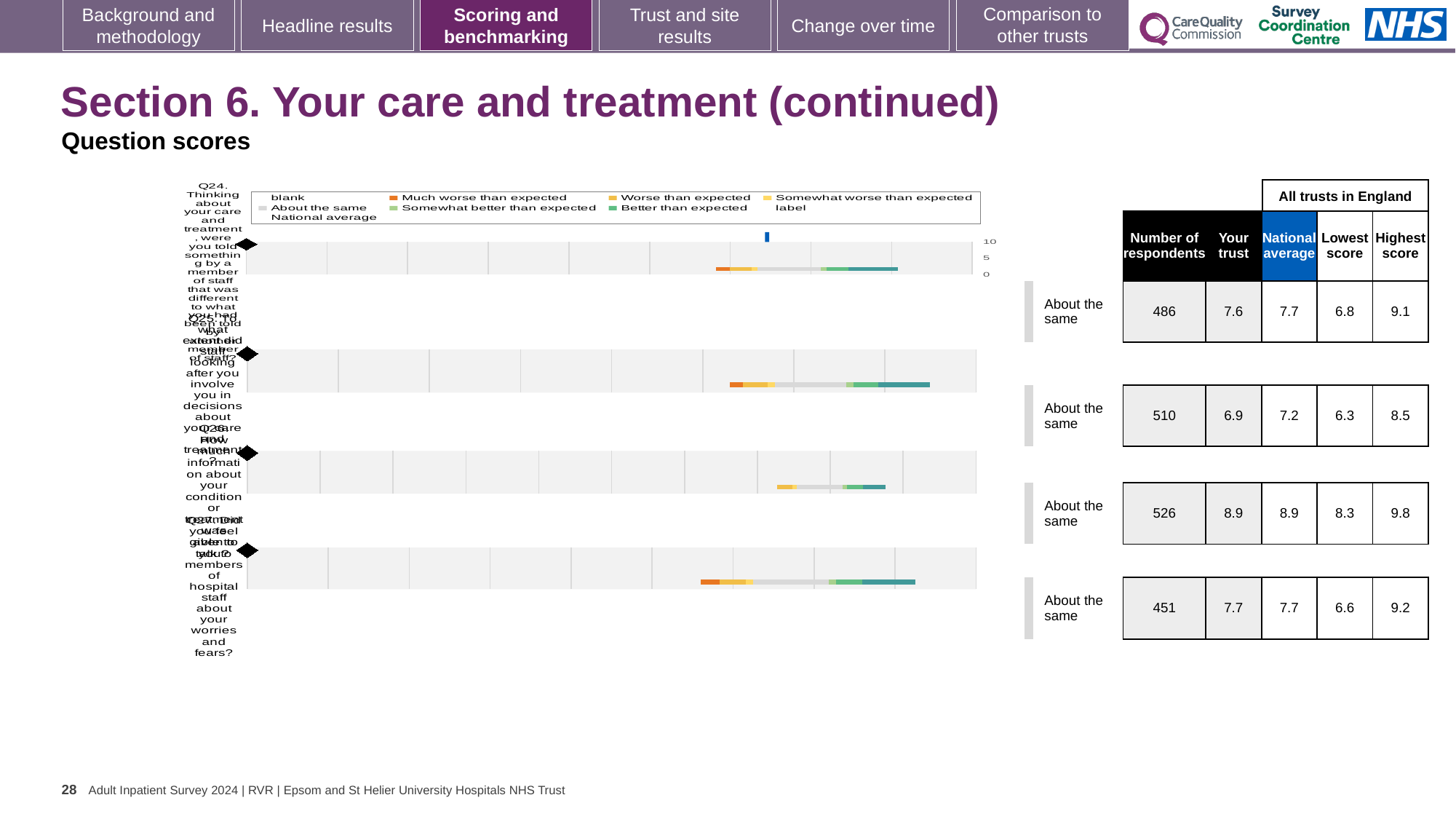
What benchmark category is shown next to the first (top) chart? About the same For the first (top) chart, what is the 'Your trust' score shown in the table? 7.6 How many entries does the chart legend list? 9 For the first (top) chart, what is the national average shown in the table? 7.7 Which chart's row has the lowest 'Your trust' score in the table? The second chart (6.9) How many question charts are shown on the slide? 4 Which chart's row has the highest number of respondents in the table? The third chart (526) What kind of chart is used for the question scores on this slide? bar chart For the second chart, which is larger: the 'Your trust' score or the national average? National average What is the highest value shown on the chart axis? 10 For the third chart, what is the difference between the highest score and the lowest score in the table? 1.5 For the second chart, what is the number of respondents shown in the table? 510